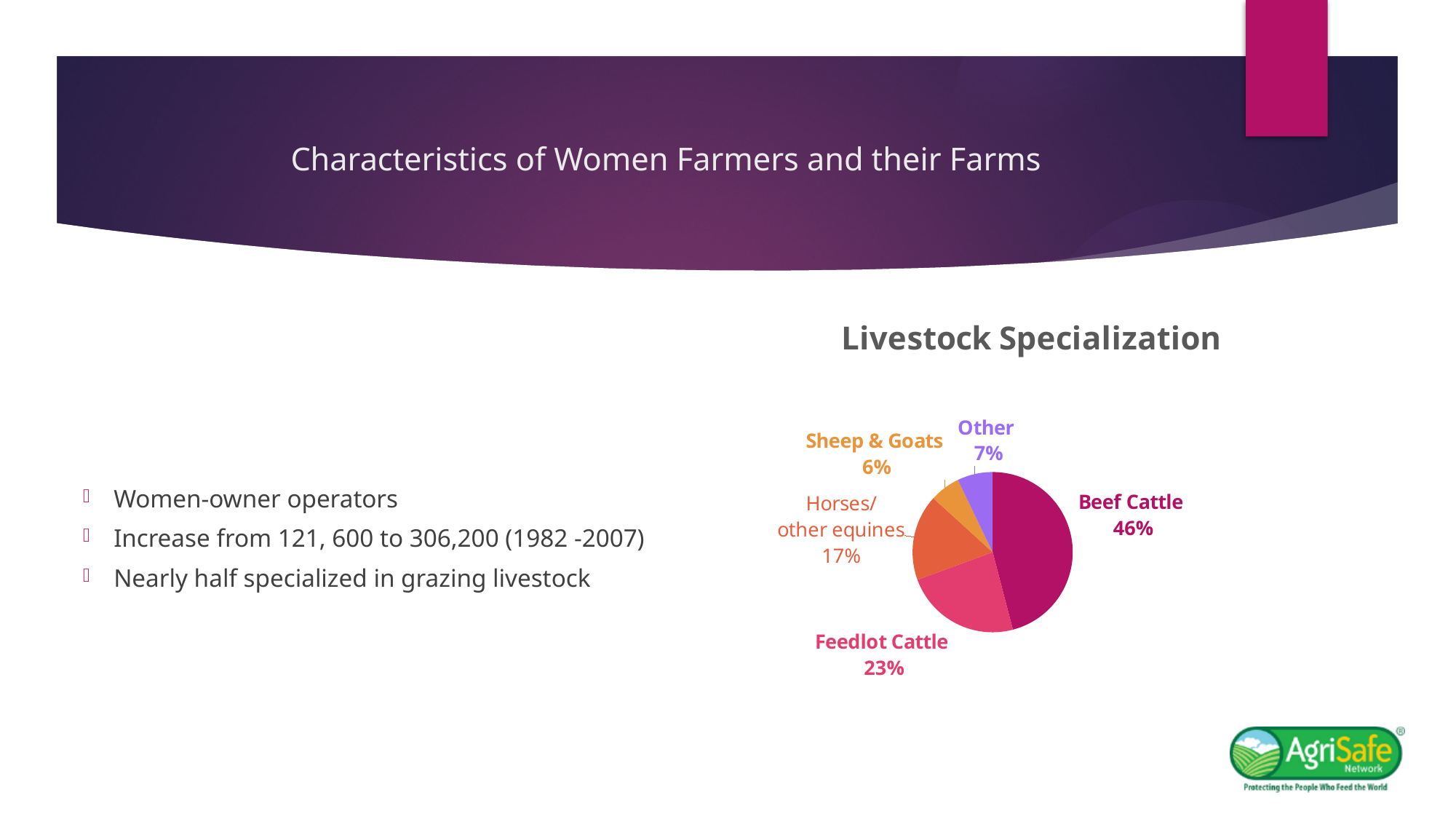
Which is larger in the Livestock Specialization chart, Horses/other equines or Other? Horses/other equines Which category has the smallest slice in the Livestock Specialization pie chart? Sheep & Goats What is the difference in percentage points between Beef Cattle and Feedlot Cattle in the Livestock Specialization chart? 23 What kind of chart is the Livestock Specialization chart? Pie chart How many categories are shown in the Livestock Specialization pie chart? 5 What is the title of the chart on the slide? Livestock Specialization Which category has the largest slice in the Livestock Specialization pie chart? Beef Cattle What share of the Livestock Specialization pie is Sheep & Goats? 6% What share of the Livestock Specialization pie is Other? 7% What share of the Livestock Specialization pie is Beef Cattle? 46% What share of the Livestock Specialization pie is Horses/other equines? 17% What share of the Livestock Specialization pie is Feedlot Cattle? 23%